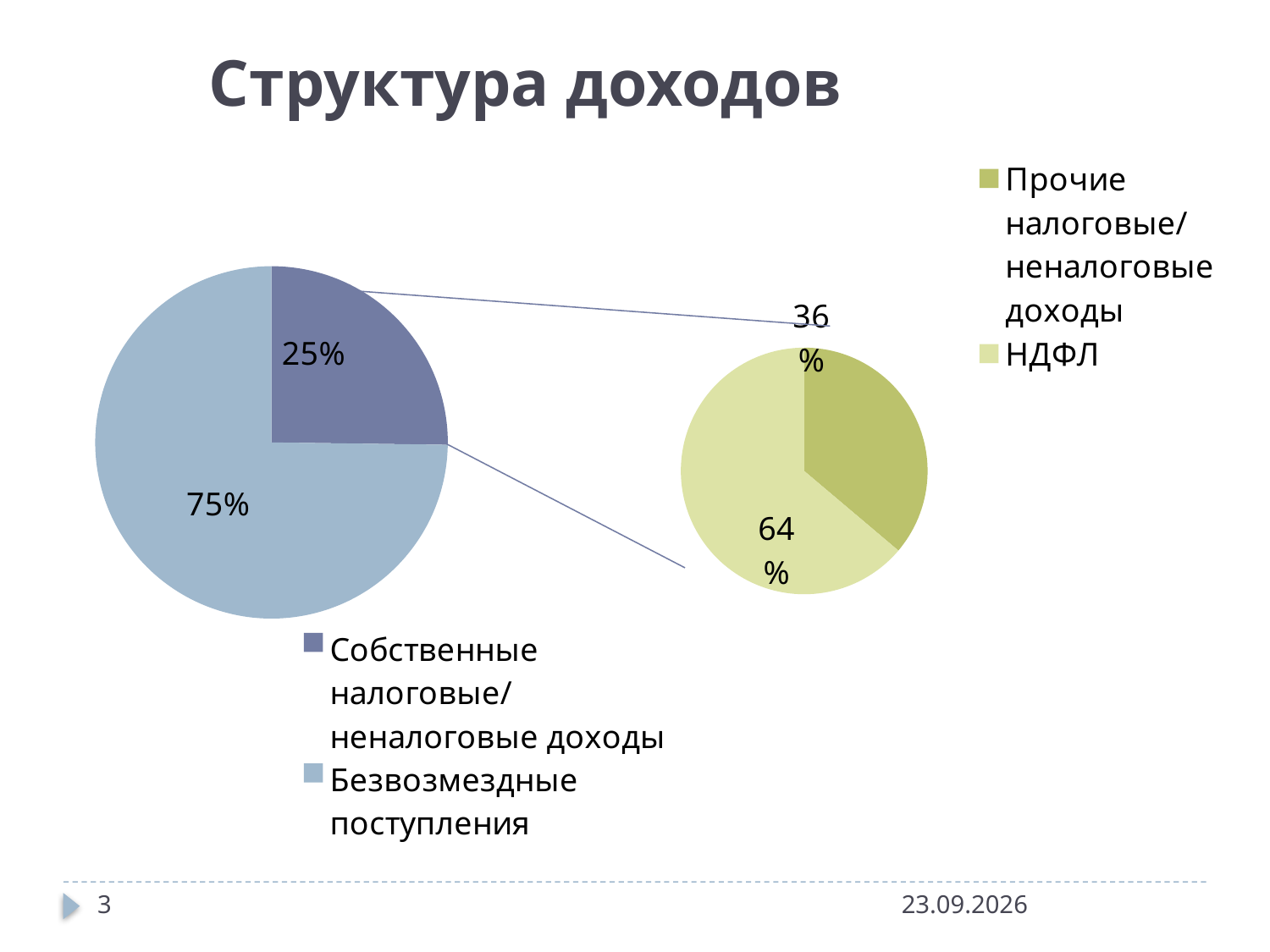
What is the title of the slide's chart? Структура доходов In the main (left) pie, which category has the largest share? Безвозмездные поступления In the smaller (right) pie, what share is labelled for НДФЛ? 64% How many slices does the main (left) pie have? 2 In the main (left) pie, what is the difference in percentage points between Безвозмездные поступления and Собственные налоговые/неналоговые доходы? 50 In the main (left) pie, what share is labelled for Безвозмездные поступления? 75% In the smaller (right) pie, what is the difference in percentage points between НДФЛ and Прочие налоговые/неналоговые доходы? 28 In the smaller (right) pie, which category has the smallest share? Прочие налоговые/неналоговые доходы What type of chart is shown on the slide? pie chart In the main (left) pie, what share is labelled for Собственные налоговые/неналоговые доходы? 25% In the smaller (right) pie, what share is labelled for Прочие налоговые/неналоговые доходы? 36% In the smaller (right) pie, which is larger: НДФЛ or Прочие налоговые/неналоговые доходы? НДФЛ